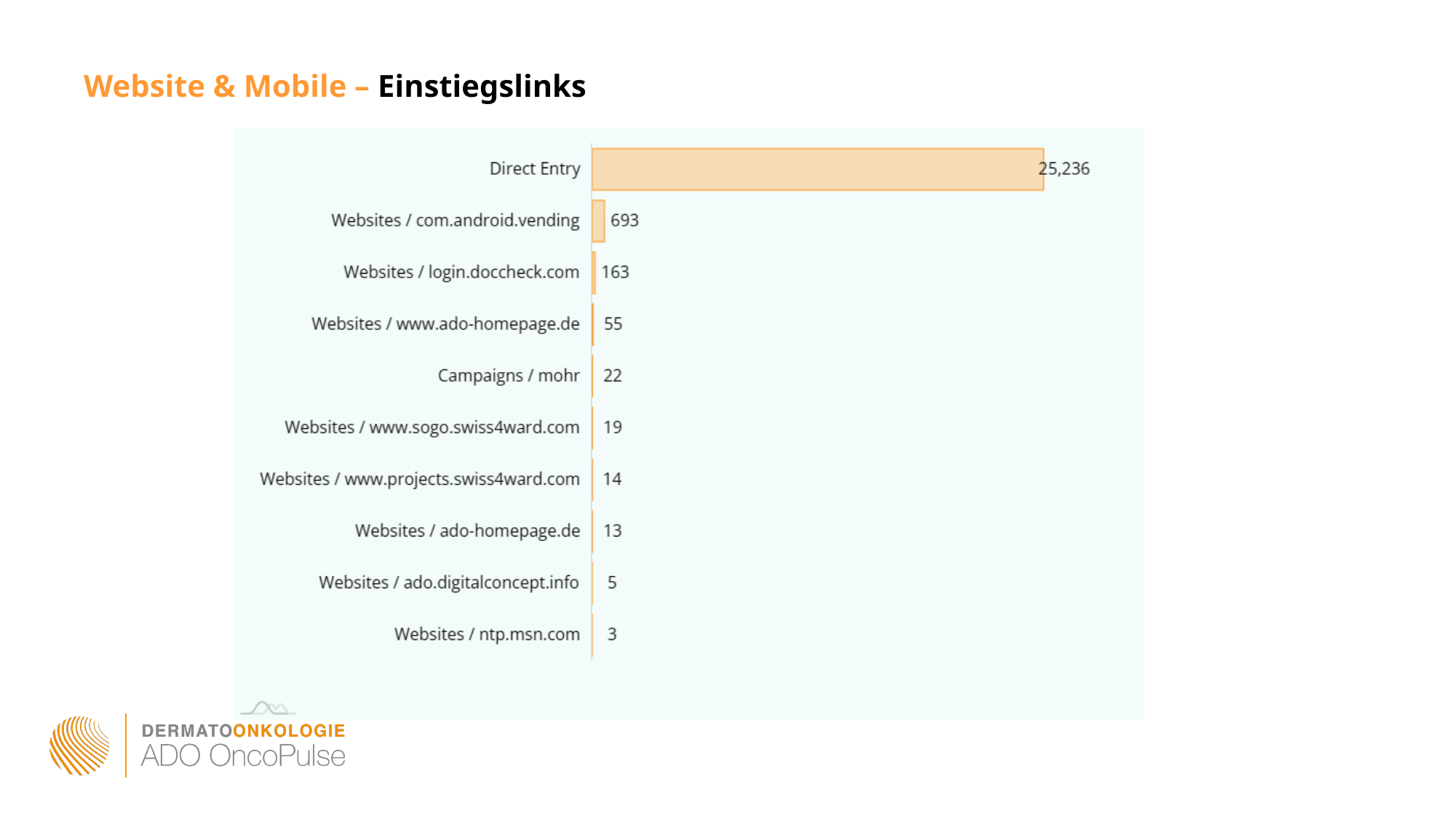
Which category has the lowest value? Websites / ntp.msn.com What is the value for Websites / com.android.vending? 693 What kind of chart is shown on the slide? Bar chart What is the value for Websites / ntp.msn.com? 3 What is the difference between Websites / www.sogo.swiss4ward.com and Websites / www.projects.swiss4ward.com? 5 What is the value for Campaigns / mohr? 22 What is the value for Websites / login.doccheck.com? 163 What is the difference between Websites / com.android.vending and Websites / login.doccheck.com? 530 Which is larger, Websites / www.ado-homepage.de or Websites / ado-homepage.de? Websites / www.ado-homepage.de How many categories are shown in the chart? 10 Which category has the highest value? Direct Entry What is the value for Direct Entry? 25,236